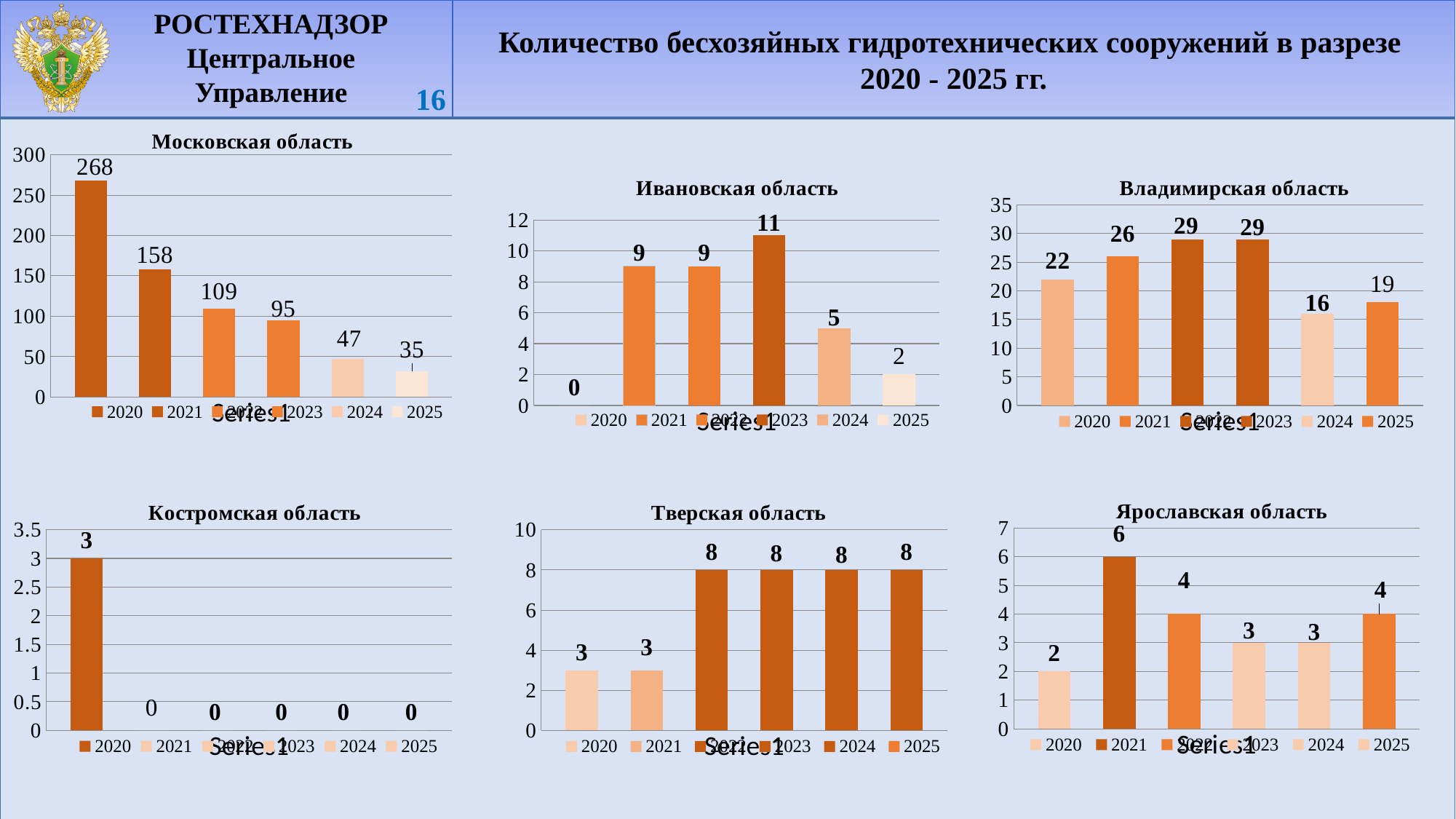
In the Костромская область chart, what is the value for 2020? 3 What kind of chart is the Тверская область chart? bar chart In the Ивановская область chart, which year has the highest value? 2023 In the Владимирская область chart, what is the value for 2024? 16 In the Владимирская область chart, which is larger, the value for 2021 or the value for 2025? 2021 In the Ивановская область chart, what is the value for 2025? 2 In the Московская область chart, what is the difference between the 2020 and 2021 values? 110 In the Ярославская область chart, which year has the highest value? 2021 How many bar charts are shown on the slide? 6 In the Московская область chart, do the values rise or fall from 2020 to 2025? fall In the Московская область chart, what is the value for 2020? 268 In the Тверская область chart, what is the value for 2021? 3